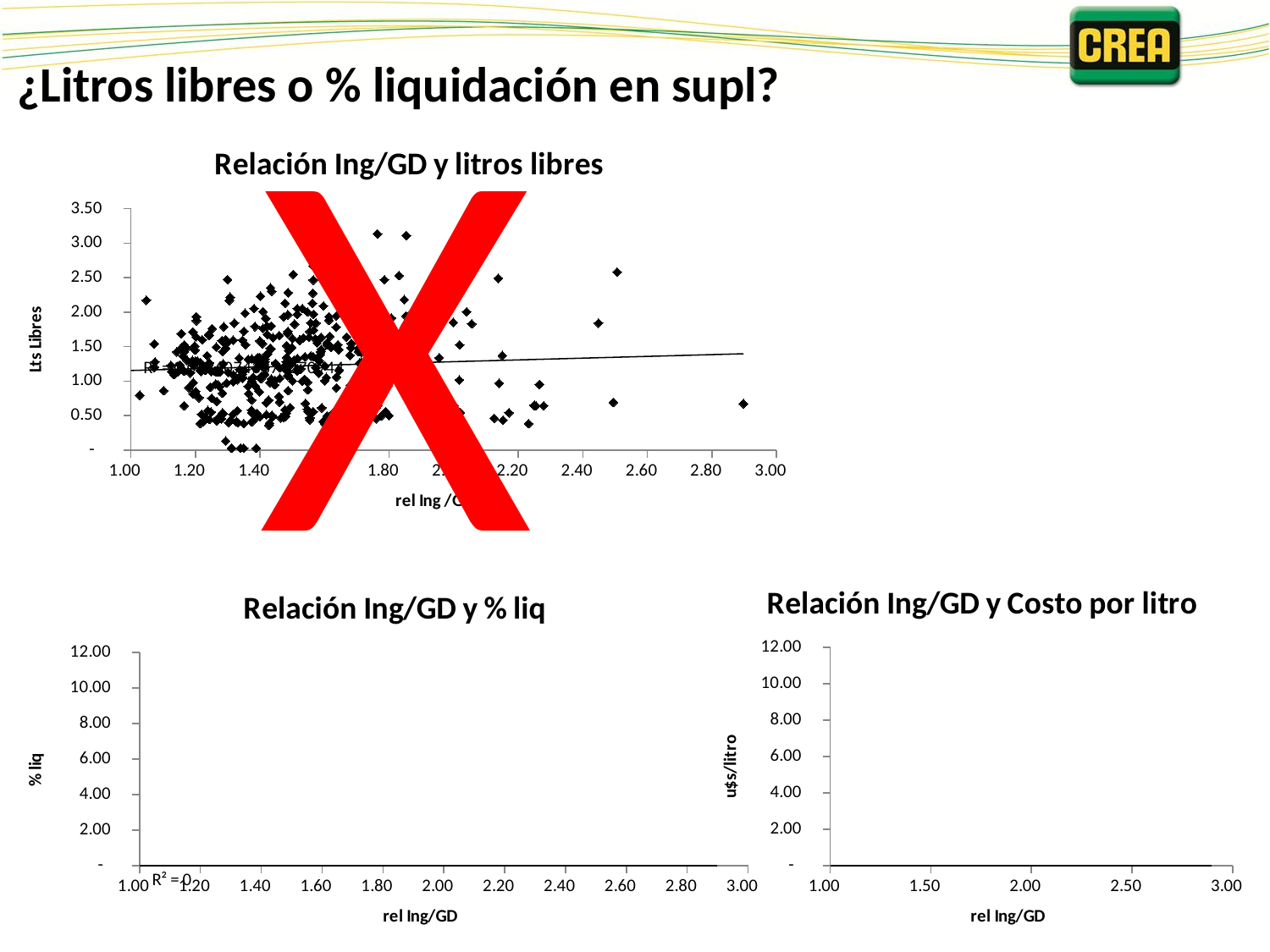
What is the y-axis title of the bottom-right chart 'Relación Ing/GD y Costo por litro'? u$s/litro What is the highest tick value shown on the y-axis of the top chart 'Relación Ing/GD y litros libres'? 3.50 What is the y-axis title of the top chart 'Relación Ing/GD y litros libres'? Lts Libres What kind of chart is the top chart titled 'Relación Ing/GD y litros libres'? scatter chart In the top chart 'Relación Ing/GD y litros libres', does the fitted trend line rise or fall as rel Ing/GD increases? rise How many charts are shown on the slide? 3